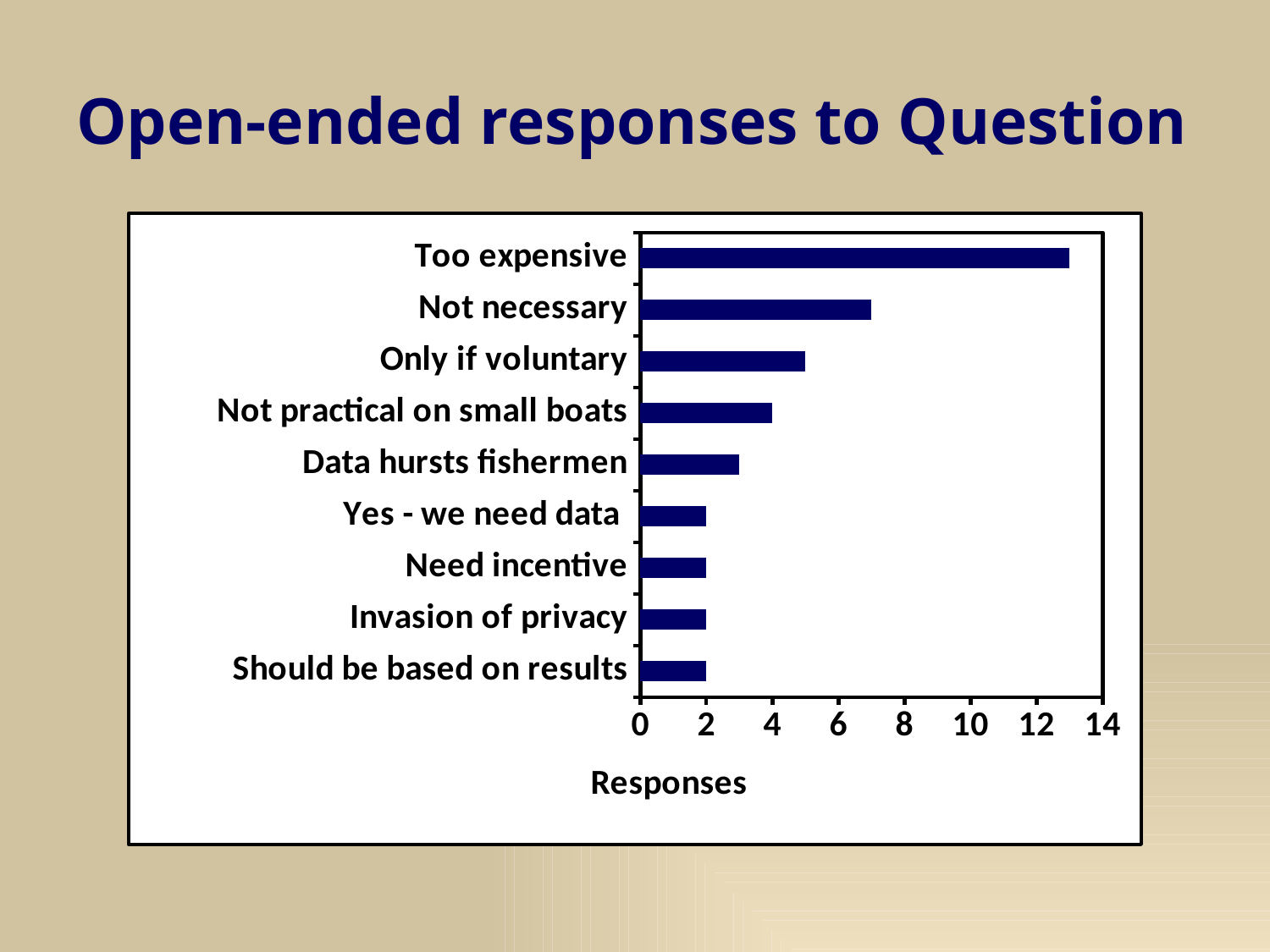
How many response categories are shown in the chart? 9 How many responses are shown for 'Should be based on results'? 2 Is the value for 'Only if voluntary' greater or less than 6? less How many responses are shown for 'Not practical on small boats'? 4 What is the label on the horizontal axis of the chart? Responses Is the value for 'Too expensive' greater or less than 12? greater Which has more responses, 'Only if voluntary' or 'Need incentive'? Only if voluntary Is the value for 'Not necessary' greater or less than 6? greater How many responses are shown for 'Yes - we need data'? 2 Which has more responses, 'Not necessary' or 'Data hursts fishermen'? Not necessary Which response category has the highest number of responses? Too expensive What kind of chart is shown on the slide? bar chart